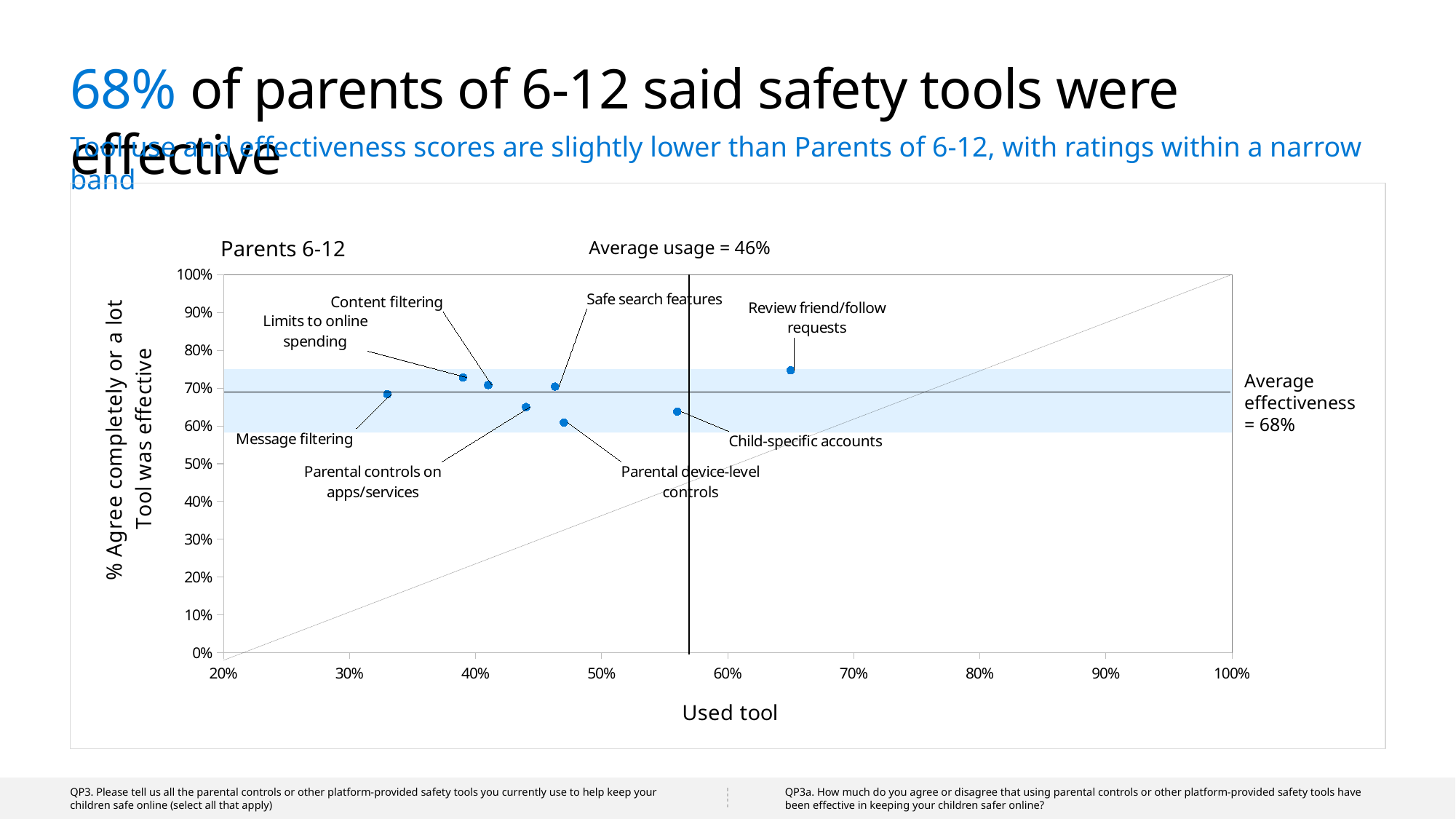
What kind of chart is shown on the slide? Scatter chart Which safety tool has the highest usage (furthest right on the Used tool axis)? Review friend/follow requests What average usage value is marked by the vertical line on the chart? 46% Is the usage value for Review friend/follow requests greater or less than 60%? greater Which has a higher effectiveness rating: Content filtering or Parental device-level controls? Content filtering Is the usage value for Message filtering greater or less than 40%? less Is the effectiveness value for Parental device-level controls greater or less than 70%? less What average effectiveness value is marked by the horizontal line on the chart? 68% Which safety tool has the lowest effectiveness rating on the chart? Parental device-level controls How many safety tools are plotted as points on the chart? 8 Which safety tool has the lowest usage (furthest left on the Used tool axis)? Message filtering